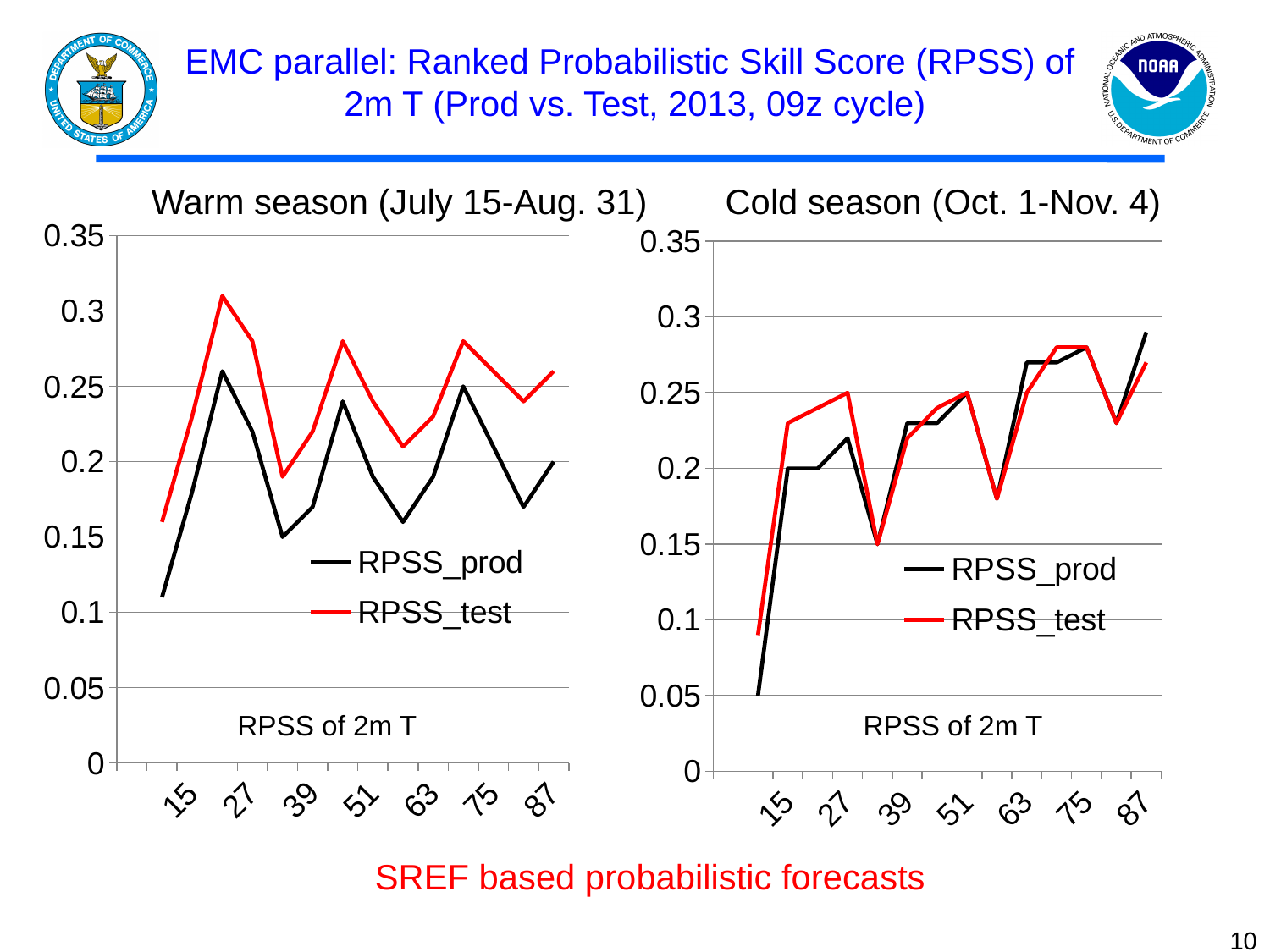
In the Warm season (July 15-Aug. 31) chart, which series has the higher values across the whole x axis? RPSS_test In the Cold season (Oct. 1-Nov. 4) chart, is the last plotted value of RPSS_prod greater or less than 0.25? greater What are the two series named in the legend of the Warm season (July 15-Aug. 31) chart? RPSS_prod and RPSS_test In the Cold season (Oct. 1-Nov. 4) chart, what colour is the RPSS_test line? red In the Warm season (July 15-Aug. 31) chart, is the highest value of RPSS_test greater or less than 0.3? greater In the Cold season (Oct. 1-Nov. 4) chart, does RPSS_prod generally rise or fall from forecast hour 15 to 87? rise In the Warm season (July 15-Aug. 31) chart, which series is higher at forecast hour 27, RPSS_prod or RPSS_test? RPSS_test In the Cold season (Oct. 1-Nov. 4) chart, is the first plotted value of RPSS_prod greater or less than 0.1? less How many series does the legend of the Cold season (Oct. 1-Nov. 4) chart list? 2 How many forecast-hour labels are shown on the x axis of the Cold season (Oct. 1-Nov. 4) chart? 7 What kind of chart is the Warm season (July 15-Aug. 31) chart? line chart